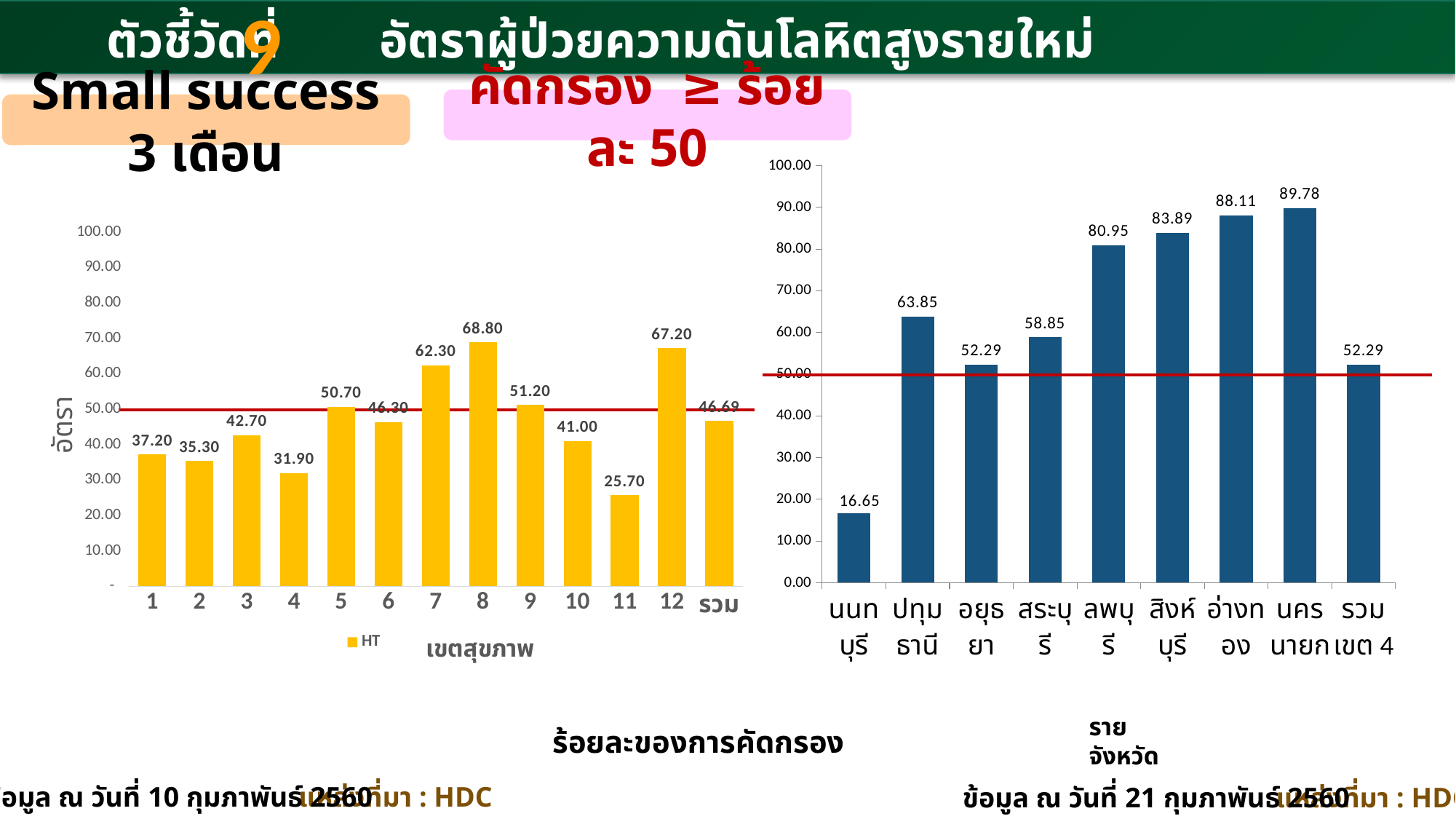
In the left chart, which region has the lowest value? 11 In the right chart, what is the value for รวม เขต 4? 52.29 In the left chart, how many series does the legend list? 1 In the right chart, how many bars are plotted? 9 In the left chart, what is the value for region 8? 68.80 In the left chart, what is the value for รวม? 46.69 In the right chart, what is the value for นครนายก? 89.78 In the right chart, which province has the lowest value? นนทบุรี In the left chart, which is larger, the value for region 7 or region 9? region 7 What type of chart is the right chart? bar chart In the left chart, what is the difference between the values for region 12 and region 11? 41.50 In the right chart, what is the difference between the values for อ่างทอง and ปทุมธานี? 24.26